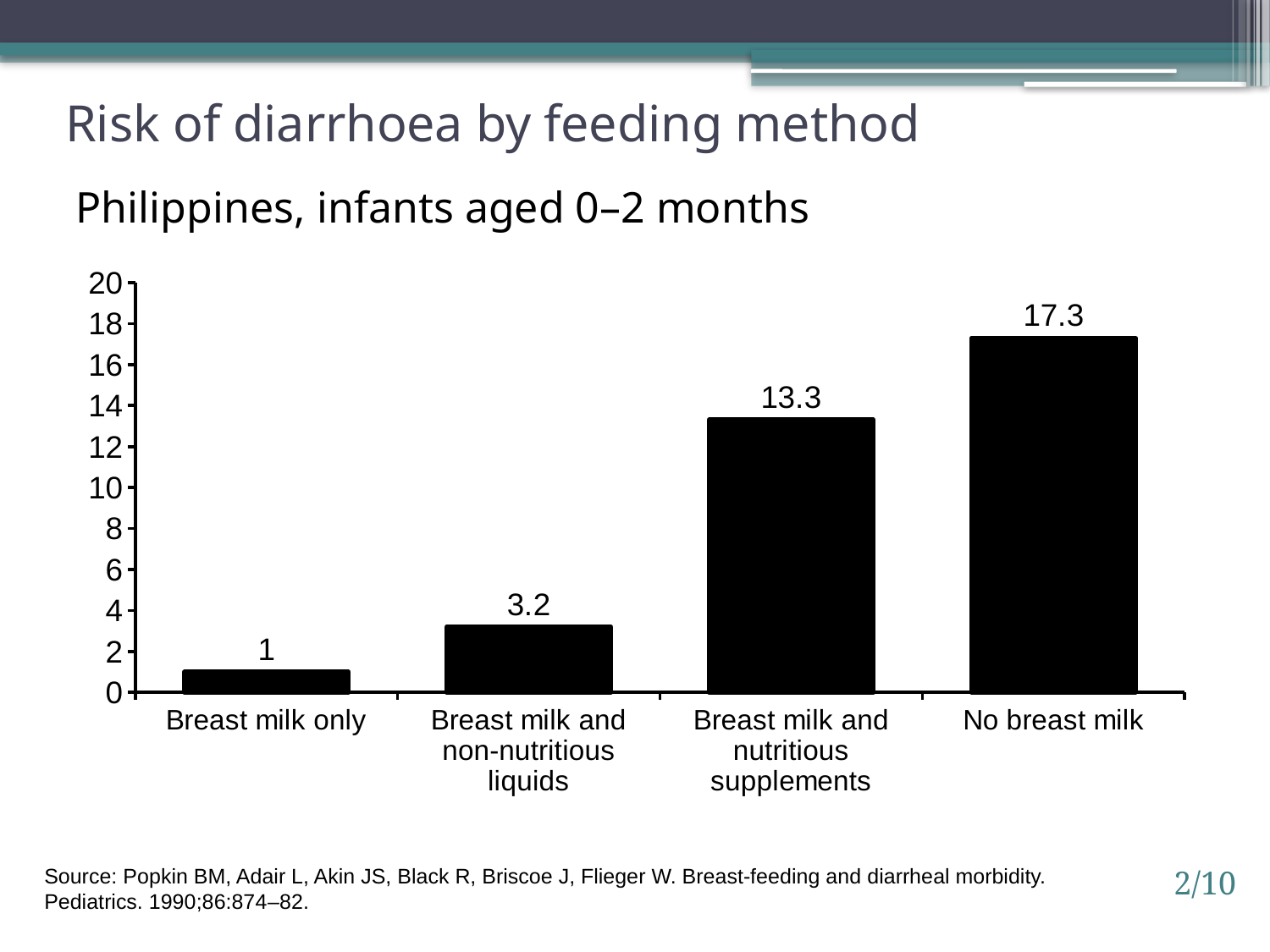
What is the difference between the values for Breast milk and non-nutritious liquids and Breast milk only? 2.2 What kind of chart is shown on the slide? Bar chart What is the value for Breast milk and nutritious supplements? 13.3 What is the value for No breast milk? 17.3 What is the value for Breast milk and non-nutritious liquids? 3.2 Which is larger, the value for Breast milk and nutritious supplements or the value for Breast milk and non-nutritious liquids? Breast milk and nutritious supplements How many feeding method categories are shown on the chart? 4 What is the value for Breast milk only? 1 Which feeding method has the highest value? No breast milk What is the difference between the values for No breast milk and Breast milk and nutritious supplements? 4 Do the values rise or fall from left to right across the categories? Rise Which feeding method has the lowest value? Breast milk only